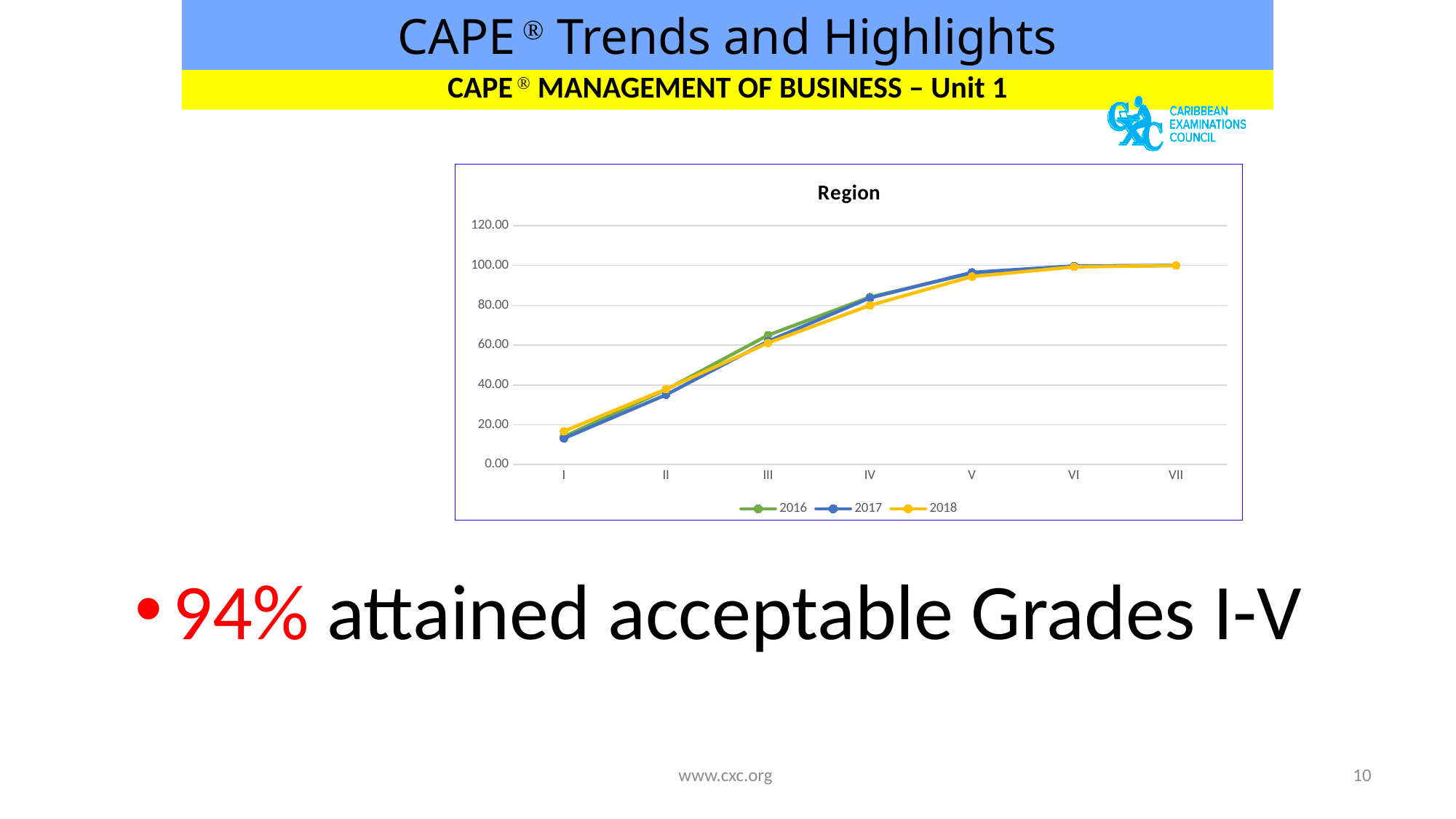
Do the values for the 2018 series rise or fall from grade I to grade VII? Rise Is the value for the 2018 series at grade II greater or less than 20.00? greater Is the value for the 2017 series at grade V greater or less than 80.00? greater How many series does the chart's legend list? 3 Is the value for the 2017 series at grade III greater or less than 40.00? greater What is the title of the chart? Region How many categories are shown on the x axis of the chart? 7 What kind of chart is shown on the slide? Line chart Which years are listed in the chart's legend? 2016, 2017, 2018